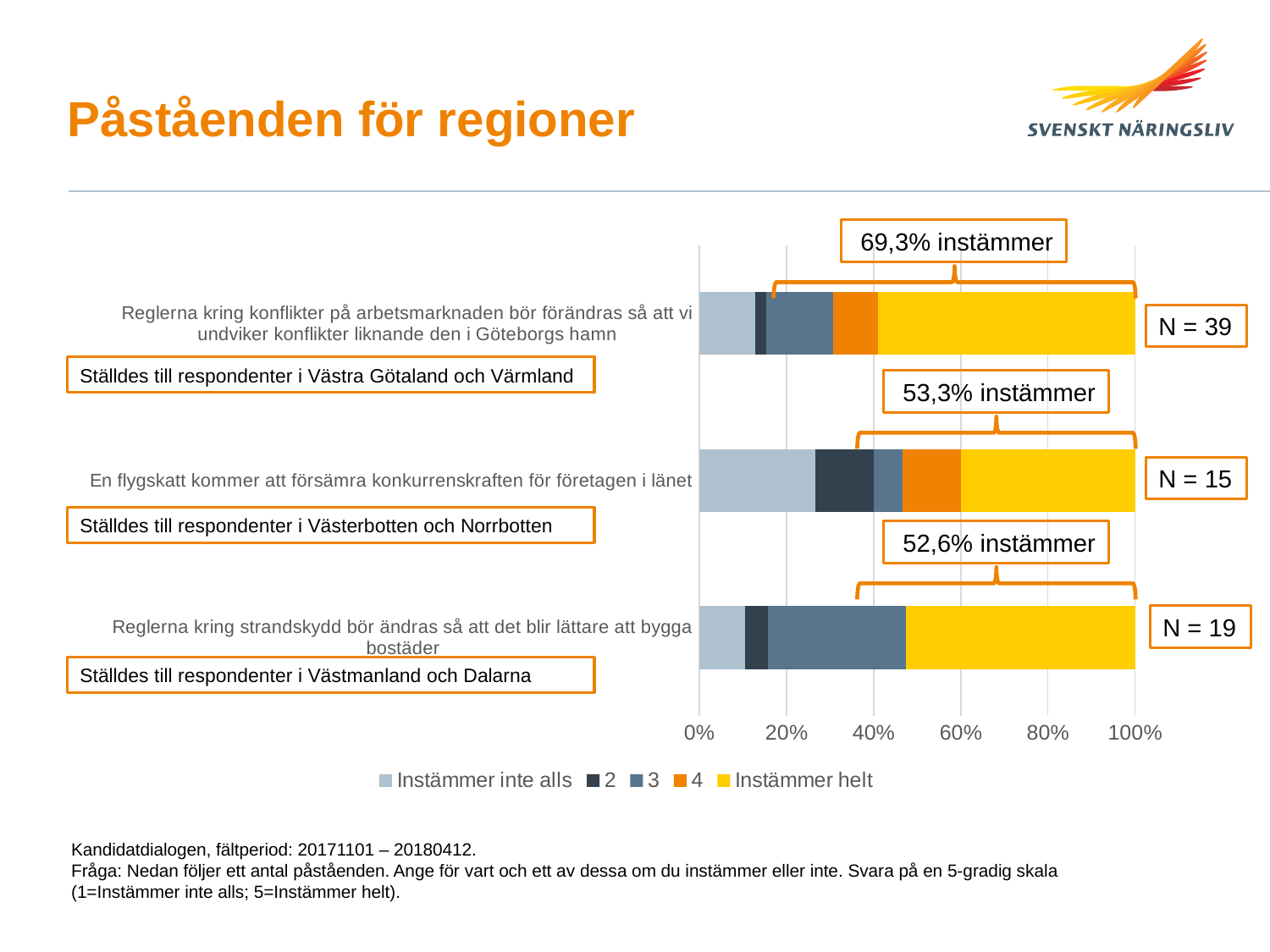
Is the "Instämmer inte alls" share for the flight tax statement greater or less than 20%? greater How many series does the legend list? 5 Which statement has the lowest share of respondents agreeing? Reglerna kring strandskydd bör ändras så att det blir lättare att bygga bostäder What is the difference in percentage points between the agree share for the labour market conflict statement (69,3%) and the shore protection statement (52,6%)? 16,7 percentage points What share of respondents agree with the statement that the shore protection rules (strandskydd) should be changed? 52,6% Which statement has the highest share of respondents agreeing? Reglerna kring konflikter på arbetsmarknaden bör förändras så att vi undviker konflikter liknande den i Göteborgs hamn What share of respondents agree ("instämmer") with the statement about changing the rules on labour market conflicts (Göteborgs hamn)? 69,3% What share of respondents agree with the statement that a flight tax will worsen the competitiveness of companies in the county? 53,3% Which statement had more respondents: the one about labour market conflicts (N = 39) or the one about shore protection (N = 19)? The one about labour market conflicts (N = 39) How many respondents (N) answered the statement about the flight tax? N = 15 What kind of chart is shown on the slide? Stacked bar chart How many statements are shown in the chart? 3